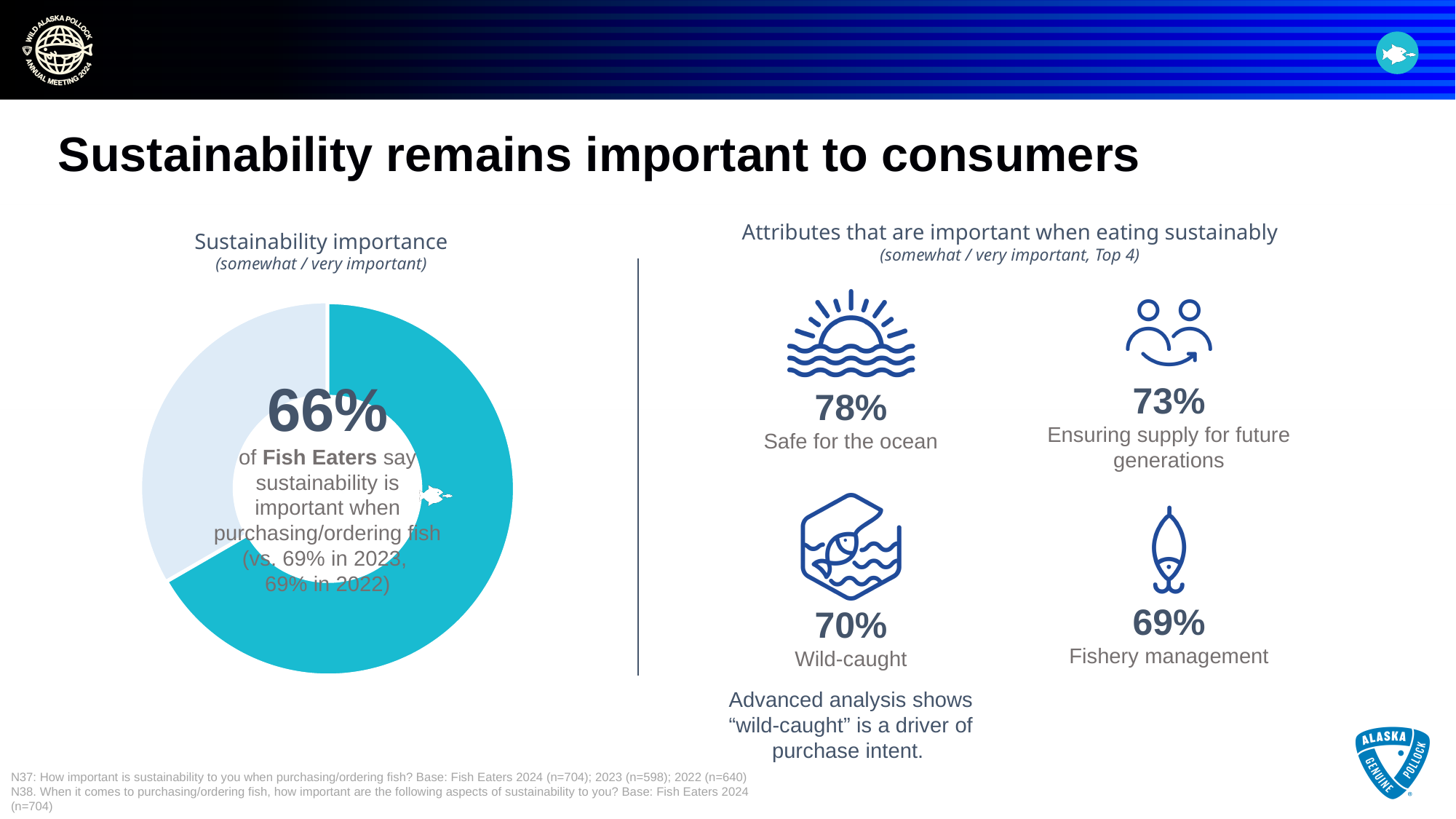
What kind of chart is shown under the title 'Sustainability importance'? Donut (pie) chart How many slices does the 'Sustainability importance' donut chart have? 2 According to the text in the 'Sustainability importance' donut chart, what was the comparable figure in 2023? 69% In the 'Attributes that are important when eating sustainably' section, which attribute has the lowest percentage? Fishery management In the 'Sustainability importance' donut chart, what share of Fish Eaters say sustainability is important when purchasing/ordering fish? 66% In the 'Sustainability importance' donut chart, which slice is larger, the teal slice or the light grey slice? The teal slice What is the subtitle shown in italics under the 'Sustainability importance' chart title? (somewhat / very important) By how many percentage points did the 'Sustainability importance' figure fall from 2023 to 2024? 3 percentage points According to the text in the 'Sustainability importance' donut chart, what was the comparable figure in 2022? 69% In the 'Attributes that are important when eating sustainably' section, what percentage is shown for 'Safe for the ocean'? 78% In the 'Sustainability importance' donut chart, is the highlighted teal share greater or less than 50%? greater In the 'Attributes that are important when eating sustainably' section, which attribute has the highest percentage? Safe for the ocean